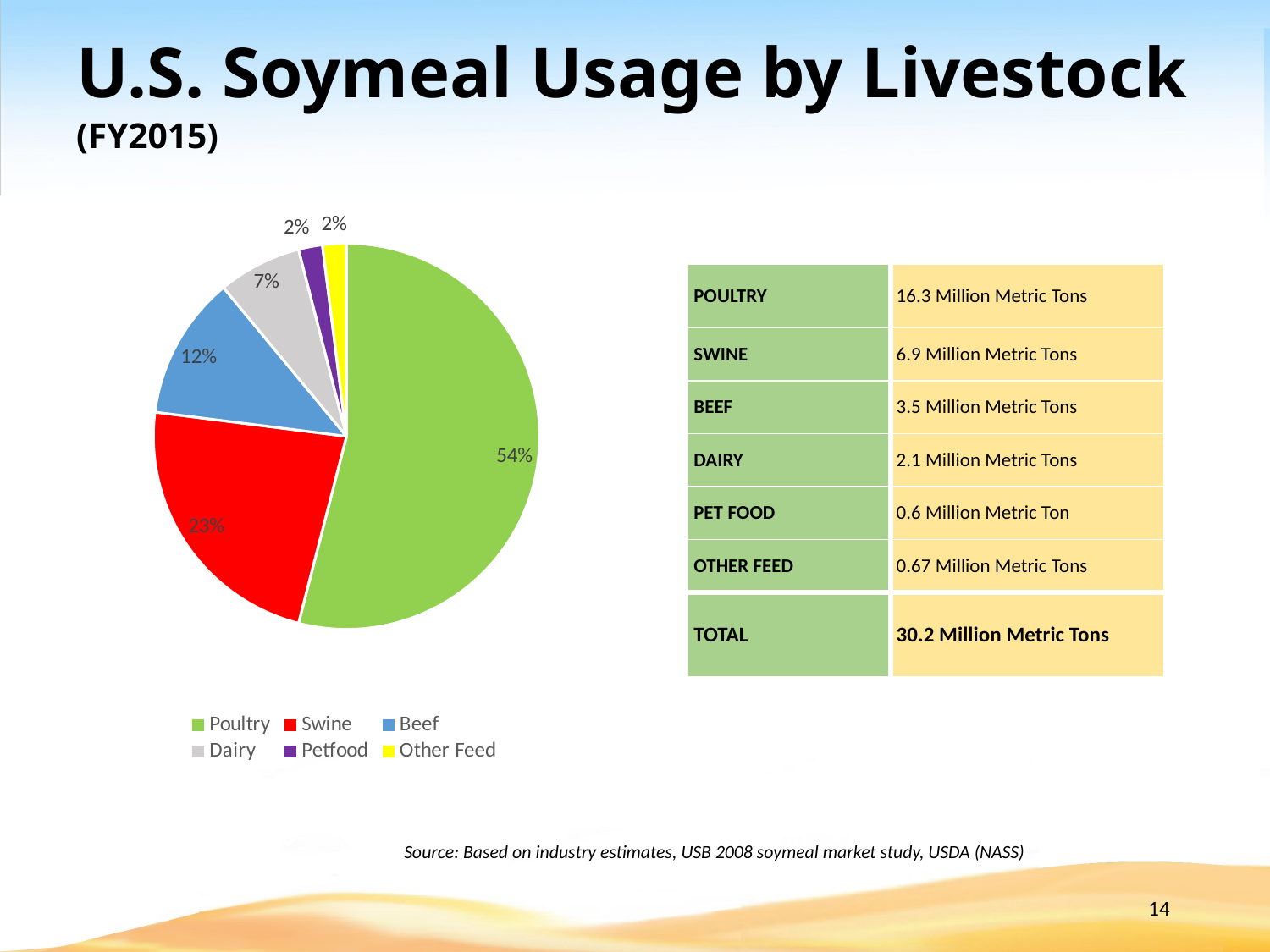
What share of the pie does Poultry account for? 54% What share of the pie does Beef account for? 12% What type of chart is shown on the slide? pie chart Which category has the largest slice of the pie? Poultry What colour is the Swine slice in the pie chart? red How many categories does the pie chart legend list? 6 What share of the pie does Dairy account for? 7% Which legend entry is shown in yellow? Other Feed What is the difference in percentage points between the Beef and Dairy slices? 5 What is the difference in percentage points between the Poultry and Swine slices? 31 Which slice is larger, Beef or Dairy? Beef